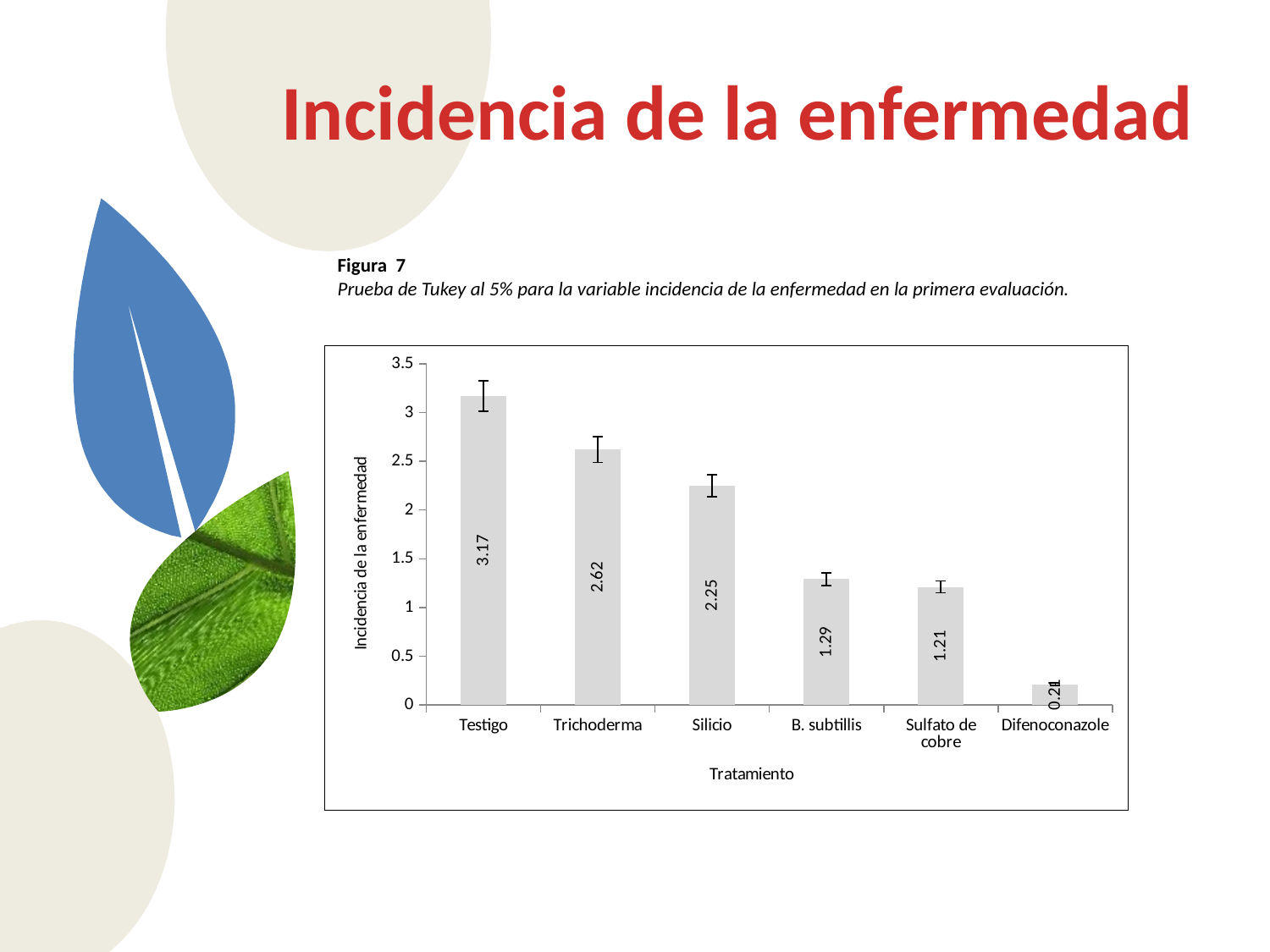
Which treatment has the lowest incidence value? Difenoconazole Do the values rise or fall from left to right along the x axis? fall Which treatment has the highest incidence value? Testigo What is the value for Trichoderma? 2.62 Which is larger, the value for Trichoderma or the value for Silicio? Trichoderma What is the difference between the values for Testigo and Trichoderma? 0.55 How many treatments are shown on the x axis? 6 Is the value for Difenoconazole greater or less than 0.5? less What is the difference between the values for Silicio and B. subtillis? 0.96 What is the value for Sulfato de cobre? 1.21 What is the value for Testigo? 3.17 What is the value for Silicio? 2.25